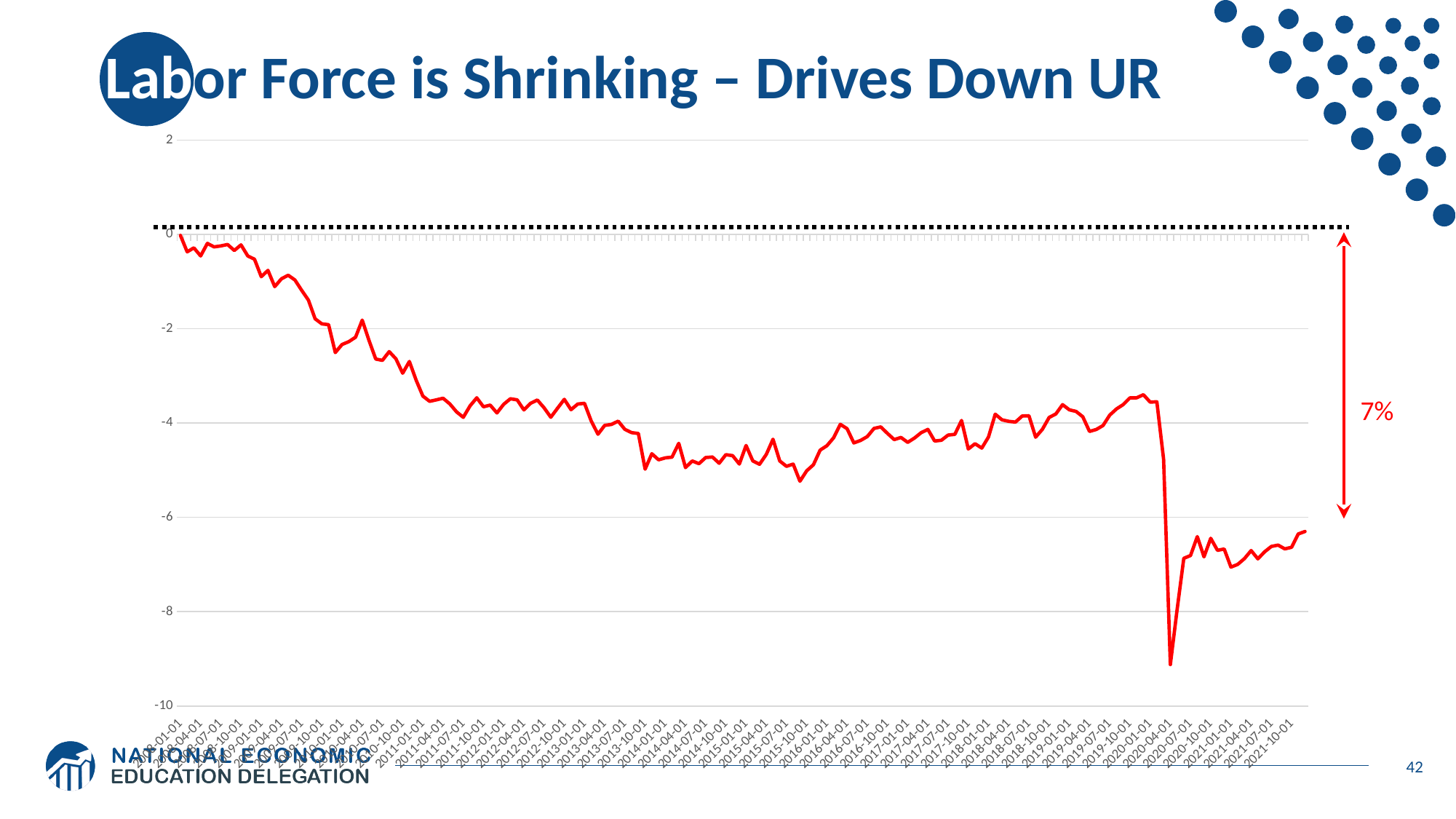
What percentage is printed next to the red double-headed arrow on the right of the chart? 7% Which is larger, the value at 2008-01-01 or the value at 2021-10-01? 2008-01-01 Around which x-axis date is the plotted value highest? 2008-01-01 What is the title of the slide containing the chart? Labor Force is Shrinking – Drives Down UR Is the value at 2016-01-01 greater or less than -6? greater Overall, does the plotted line rise or fall from 2008-01-01 to 2021-10-01? fall Is the value at 2012-01-01 greater or less than -2? less Is the value at 2021-10-01 greater or less than -8? greater Around which x-axis date does the line reach its lowest point? 2020-04-01 What kind of chart is shown on the slide? line chart